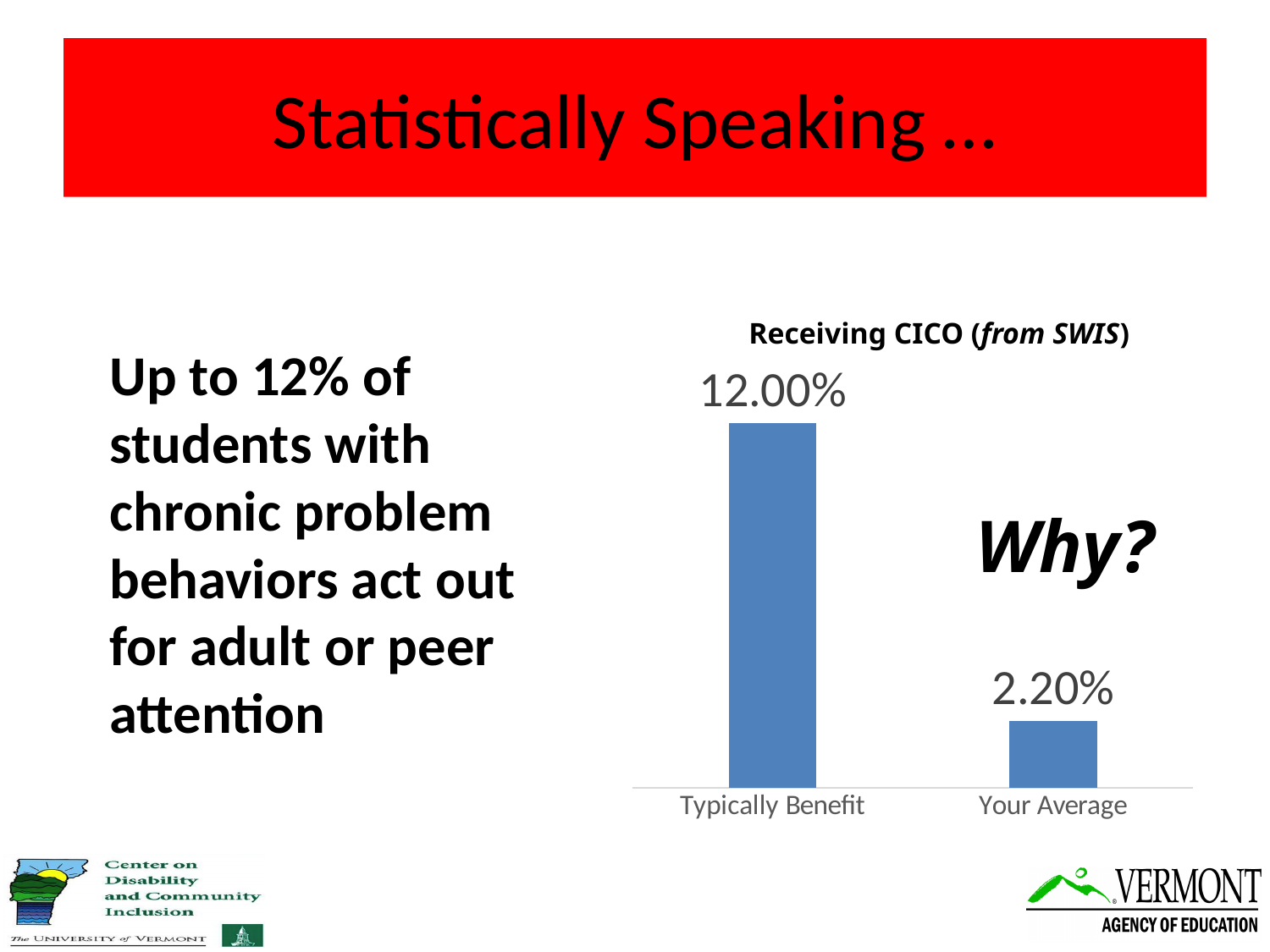
What is the title of the chart? Receiving CICO (from SWIS) Do the values rise or fall from left to right across the categories? Fall What is the value for Your Average? 2.20% How many categories are shown in the chart? 2 What kind of chart is shown on the slide? Bar chart Which is larger, the value for Typically Benefit or the value for Your Average? Typically Benefit What is the difference between the Typically Benefit and Your Average values? 9.80% Which category has the highest value? Typically Benefit Which category has the lowest value? Your Average What colour are the bars in the chart? Blue What is the value for Typically Benefit? 12.00%